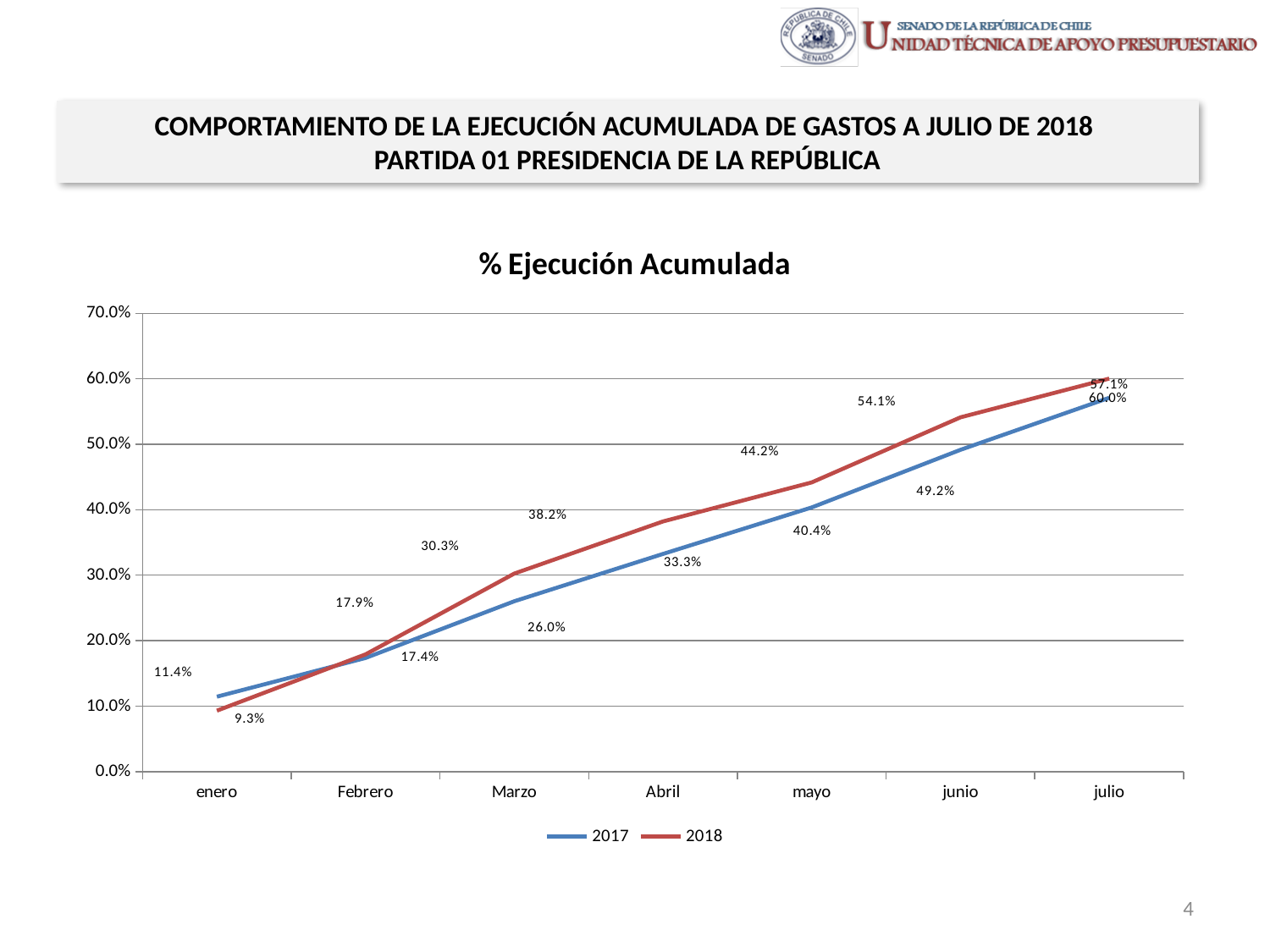
What is the value for 2017 in mayo? 40.4% What is the value for 2018 in junio? 54.1% What is the value for 2017 in enero? 11.4% What is the difference between the 2018 and 2017 values in mayo? 3.8 percentage points Do the values for 2018 rise or fall from enero to julio? Rise How many series does the legend list? 2 What is the value for 2018 in enero? 9.3% What is the value for 2018 in Marzo? 30.3% What is the title of the chart? % Ejecución Acumulada What kind of chart is shown on the slide? Line chart How many months are shown on the x axis? 7 In enero, which series has the higher value, 2017 or 2018? 2017